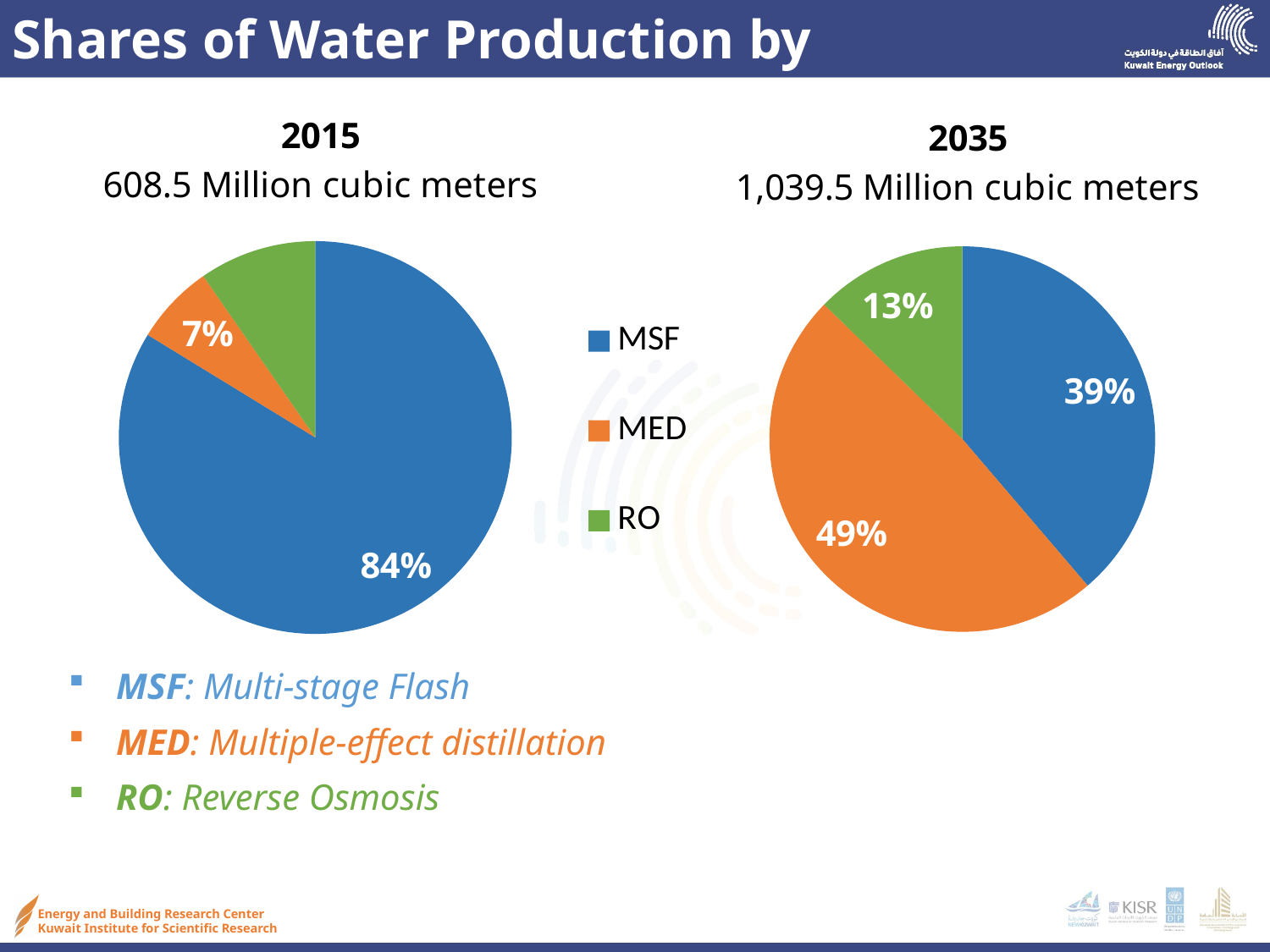
In the 2035 pie chart, what share of water production comes from MED? 49% In the 2035 pie chart, what share of water production comes from RO? 13% How many technologies does the legend list? 3 Is the MSF share larger in the 2015 pie chart or the 2035 pie chart? 2015 In the 2015 pie chart, which technology has the largest share? MSF In the 2035 pie chart, which technology has the smallest share? RO In the 2015 pie chart, what share of water production comes from MSF? 84% What type of chart is used to show the 2035 water production shares? Pie chart In the 2015 pie chart, how many percentage points larger is the MSF share than the MED share? 77 percentage points In the 2035 pie chart, how many percentage points larger is the MED share than the MSF share? 10 percentage points In the 2035 pie chart, which technology has the largest share? MED In the 2015 pie chart, what share of water production comes from MED? 7%